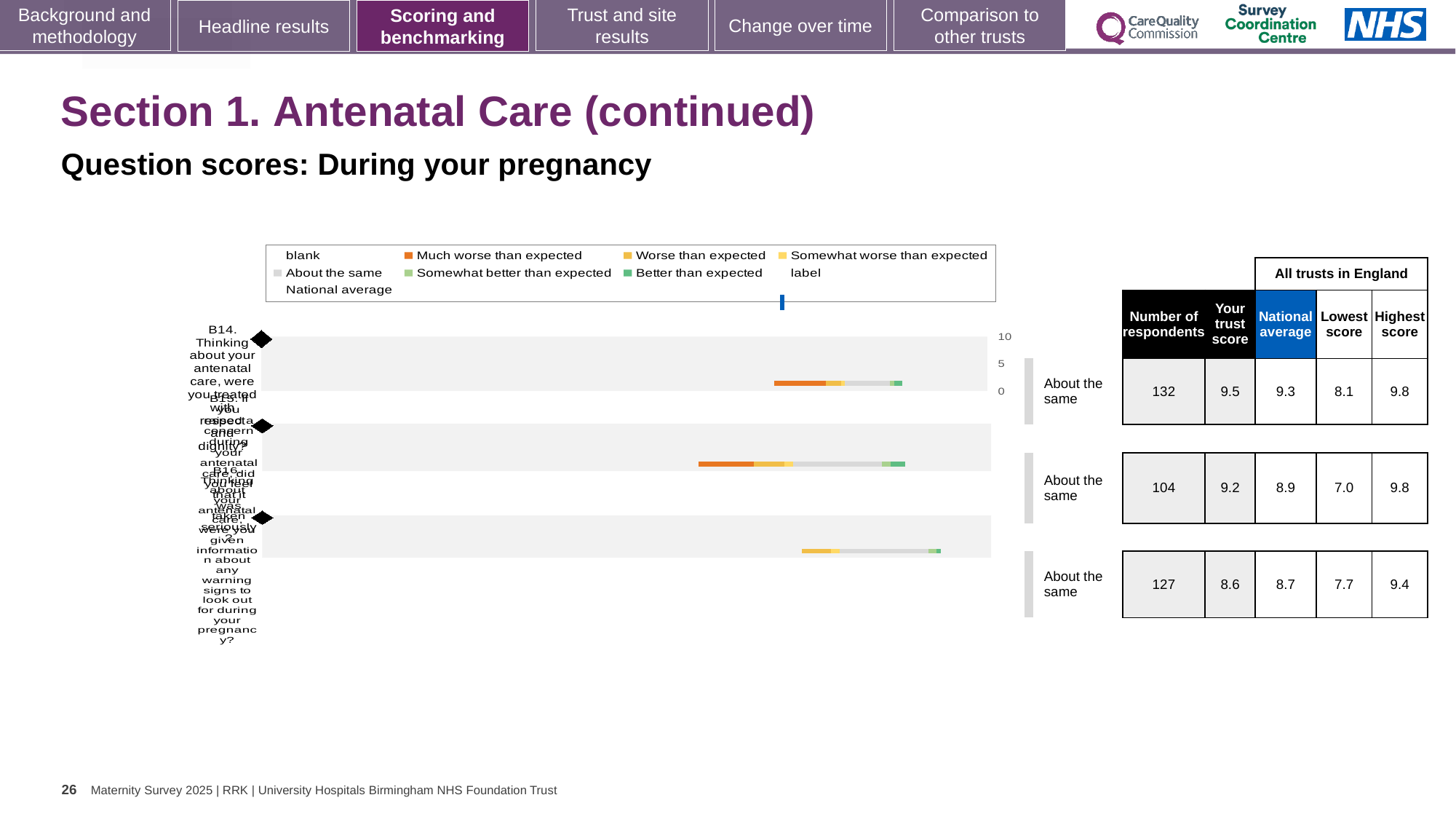
In the table beside the chart, what is the national average for the third question (B16)? 8.7 What is the highest score across all trusts in England for the first question (B14)? 9.8 How many question bars (B14, B15, B16) are plotted in the chart? 3 Which row in the table has the lowest 'Lowest score' value? Second row (B15), 7.0 What benchmark category is shown next to each of the three bars? About the same What colour does the legend use for 'Much worse than expected'? Orange In the table beside the chart, what is the 'Your trust score' for the second question (B15)? 9.2 What kind of chart is shown on the slide? bar chart Which of the three questions has the highest 'Your trust score' in the table? B14 (first row), 9.5 For the first question (B14), what is the difference between 'Your trust score' and the national average? 0.2 In the table beside the chart, what is the number of respondents for the first question (B14)? 132 For the third question (B16), which is larger: 'Your trust score' or the national average? National average